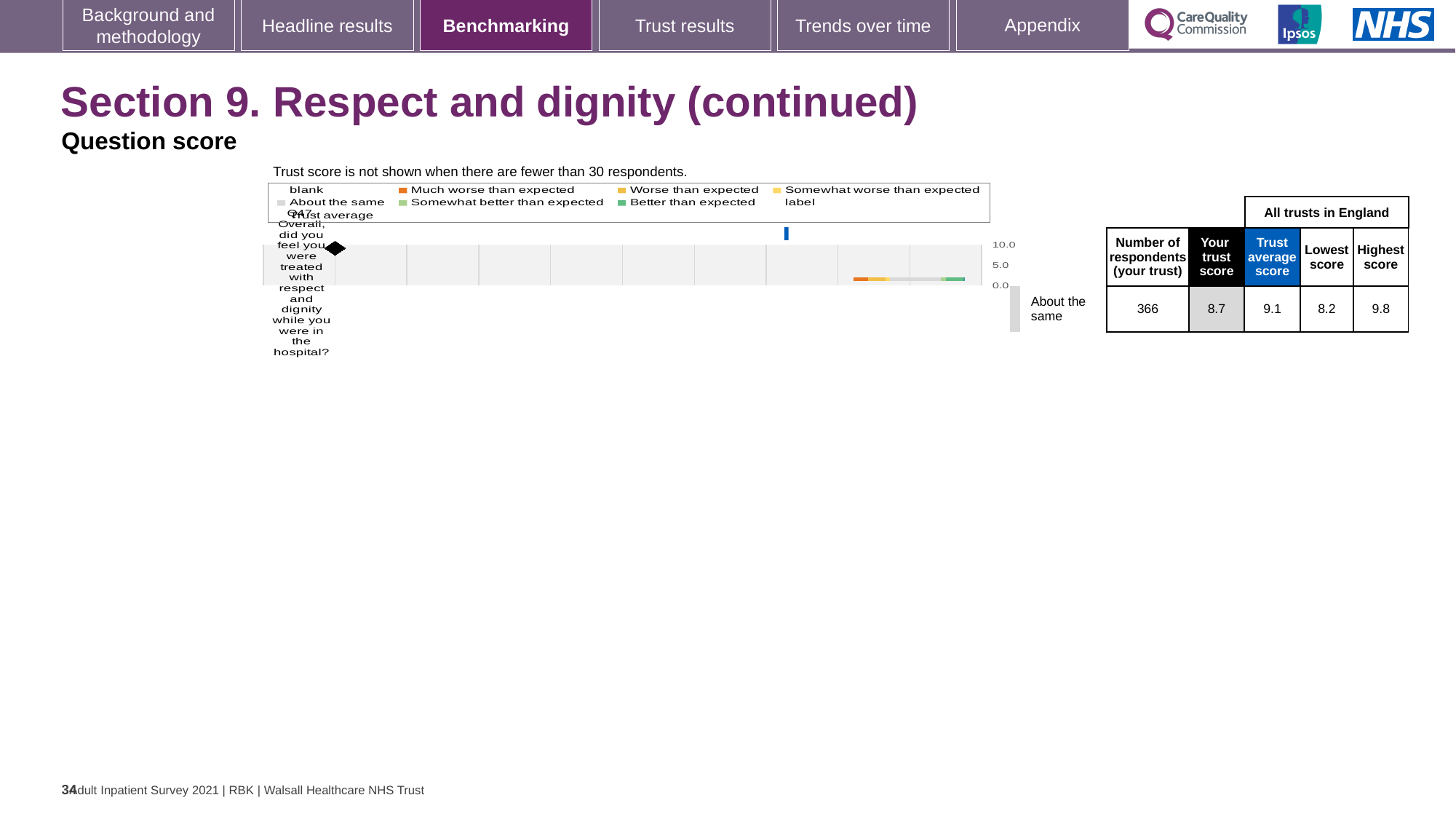
What is the difference between the highest score and the lowest score for Q47 in the table? 1.6 Which colour in the legend represents 'Much worse than expected'? orange Which is larger for Q47: your trust score or the trust average score? trust average score What is the highest tick value shown on the chart's axis? 10.0 What is the question number plotted on the chart? Q47 According to the table next to the chart, what is the highest score across all trusts in England for Q47? 9.8 According to the table next to the chart, what is the trust average score for Q47? 9.1 According to the table next to the chart, what is your trust score for Q47? 8.7 What kind of chart is shown on the slide? bar chart How many questions are plotted on the chart? 1 According to the table next to the chart, what is the number of respondents for Q47 at your trust? 366 According to the table next to the chart, what is the lowest score across all trusts in England for Q47? 8.2